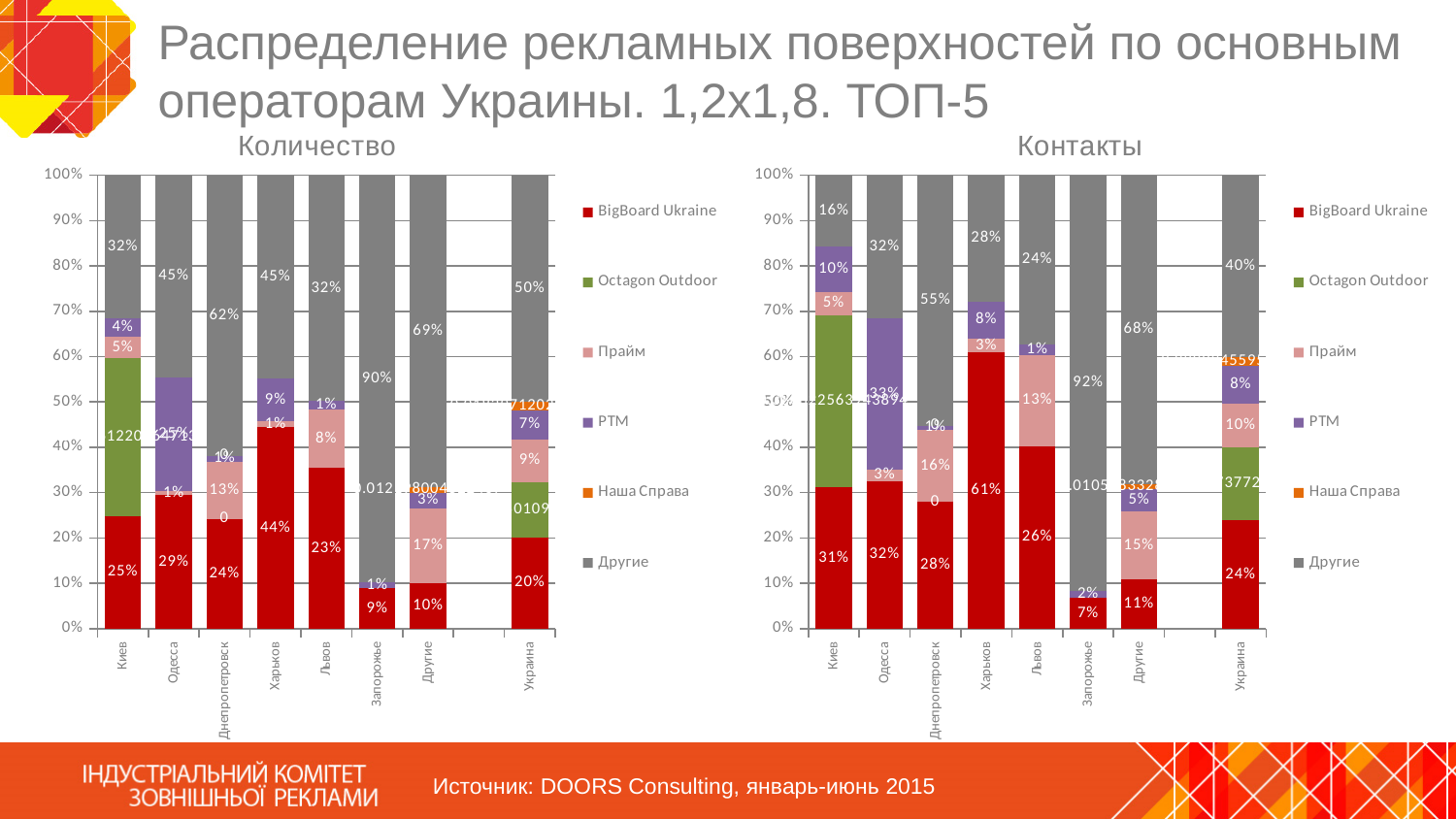
In the Контакты chart, which category has the highest BigBoard Ukraine share? Харьков In the Количество chart, which category has the lowest BigBoard Ukraine share? Запорожье How many categories are shown on the x axis of the Контакты chart? 8 In the Количество chart, what is the Другие share for Запорожье? 90% In the Контакты chart, what is the Другие share for Украина? 40% What type of chart is the Контакты chart? Stacked bar chart In the Количество chart, which is larger: the Другие share for Днепропетровск or for Одесса? Днепропетровск In the Контакты chart, what is the Прайм share for Львов? 13% In the Количество chart, what is the BigBoard Ukraine share for Харьков? 44% In the Количество chart, what is the Прайм share for Другие? 17% In the Контакты chart, what is the BigBoard Ukraine share for Харьков? 61% How many series does the legend of the Количество chart list? 6